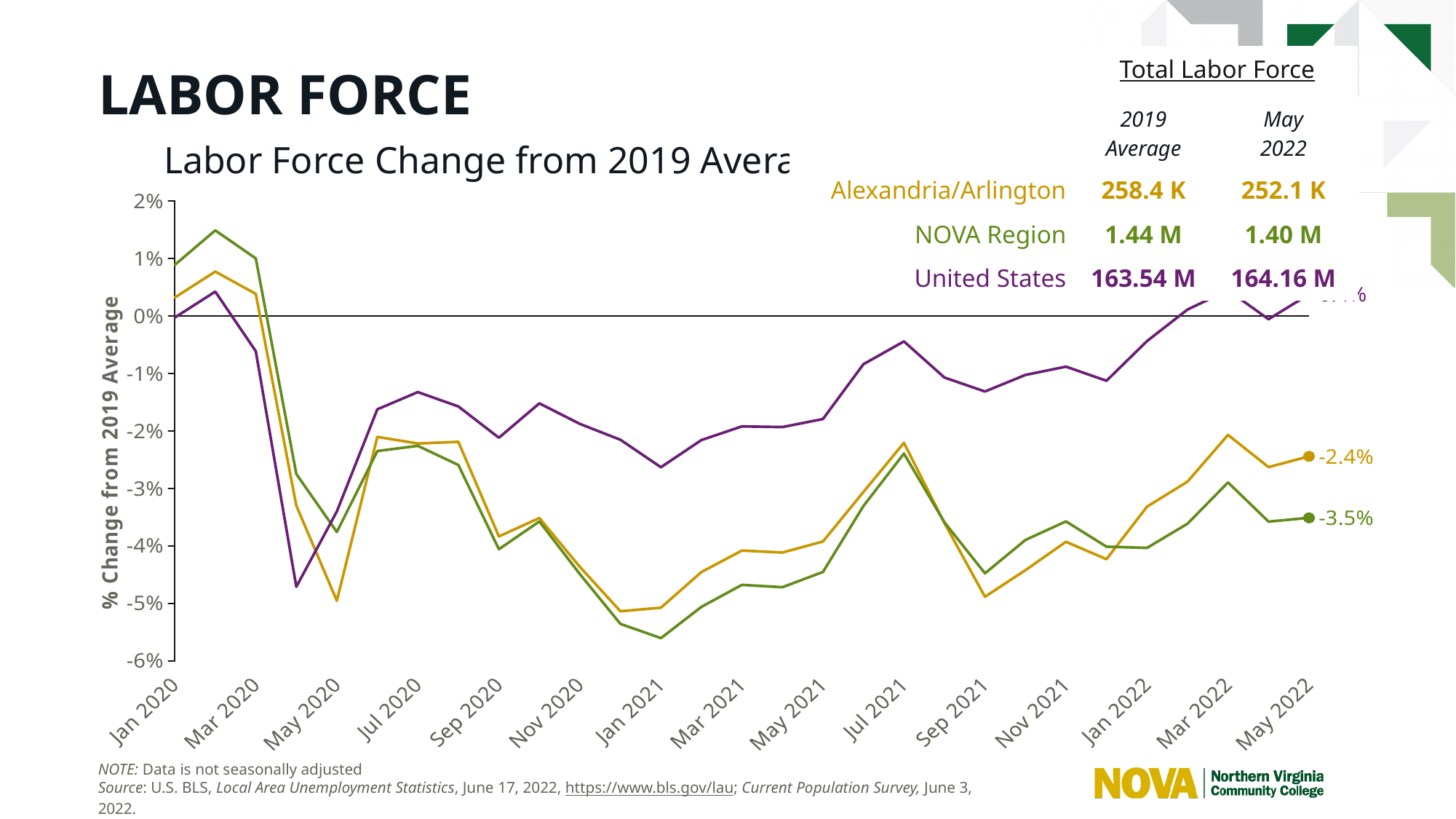
What kind of chart is shown on the slide? line chart How many series are plotted on the chart? 3 In May 2022, which has the higher labor force change from the 2019 average: Alexandria/Arlington or the NOVA Region? Alexandria/Arlington Which series has the lowest value in May 2022? NOVA Region What is the difference between the May 2022 values for Alexandria/Arlington (-2.4%) and the NOVA Region (-3.5%)? 1.1 percentage points Is the United States value in Jan 2021 greater or less than -2%? less What is the labor force change from the 2019 average for the NOVA Region in May 2022? -3.5% Which series has the highest value in Jan 2021? United States Is the NOVA Region value in Jan 2021 greater or less than -5%? less Does the United States line rise or fall between Jan 2022 and Mar 2022? rise What is the title of the vertical axis? % Change from 2019 Average What is the labor force change from the 2019 average for Alexandria/Arlington in May 2022? -2.4%